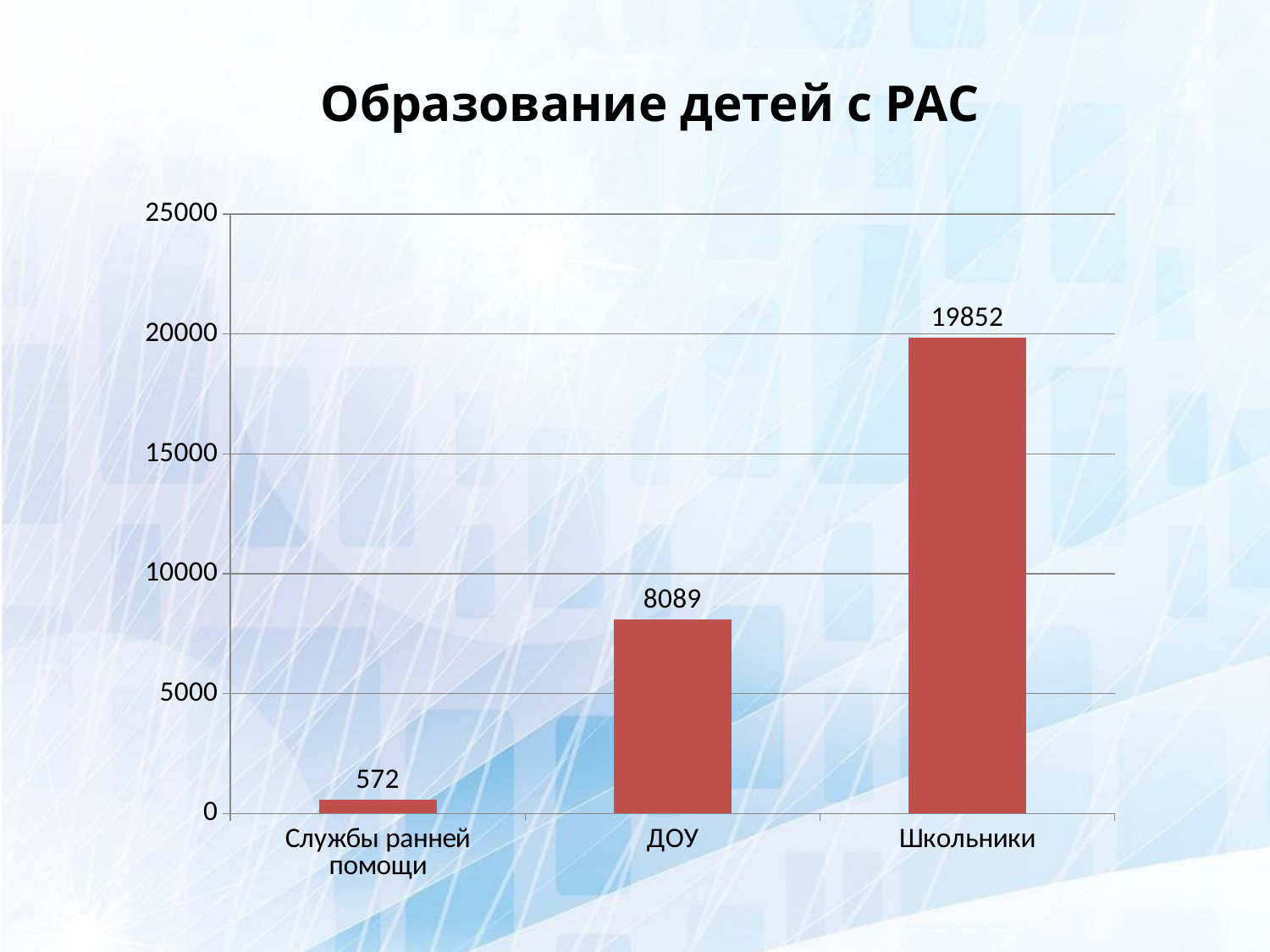
What is the value for ДОУ? 8089 What kind of chart is shown on the slide? bar chart How many categories are shown on the chart? 3 What is the difference between the values for ДОУ and Службы ранней помощи? 7517 Which category has the lowest value? Службы ранней помощи What is the value for Школьники? 19852 What is the title of the slide? Образование детей с РАС Which category has the highest value? Школьники Which is larger, the value for ДОУ or the value for Службы ранней помощи? ДОУ Is the value for Школьники greater or less than 15000? greater What is the difference between the values for Школьники and ДОУ? 11763 What is the value for Службы ранней помощи? 572